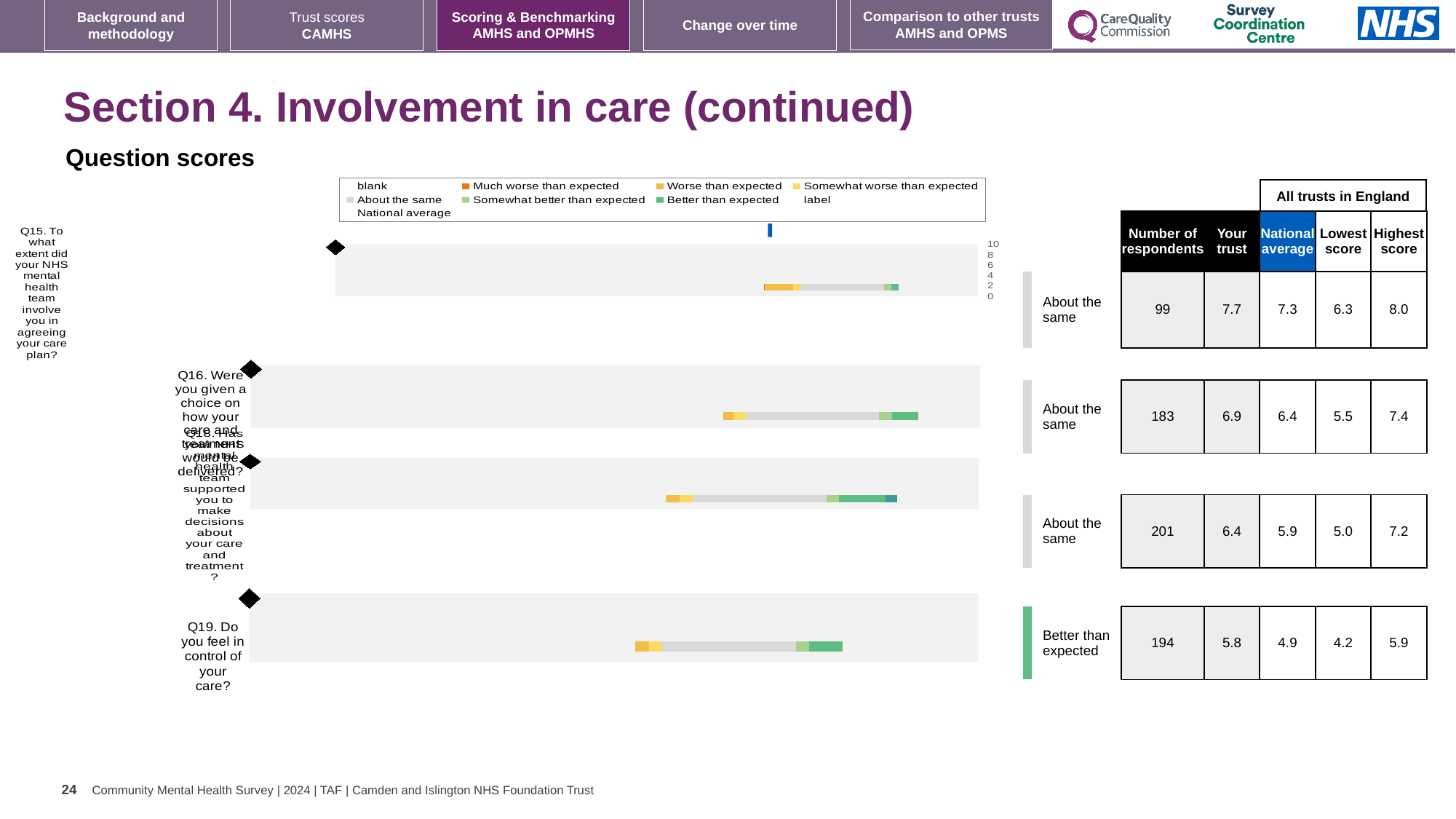
Which question has the highest 'Your trust' score? Q15 What is the highest score among all trusts in England for Q19 (Do you feel in control of your care?)? 5.9 Which question has the lowest 'Your trust' score? Q19 How many questions are plotted in the question scores chart? 4 Which has the higher 'Your trust' score, Q16 or Q18? Q16 What kind of chart is used to show the question scores on this slide? bar chart Is the 'Your trust' score for Q19 greater or less than 6? less Which question is rated 'Better than expected' rather than 'About the same'? Q19 How many respondents answered Q18 (Has your NHS mental health team supported you to make decisions about your care and treatment?)? 201 What is the 'Your trust' score for Q15 (To what extent did your NHS mental health team involve you in agreeing your care plan?)? 7.7 By how much does the trust's score for Q19 exceed the national average for Q19? 0.9 What is the national average score for Q16 (Were you given a choice on how your care and treatment would be delivered?)? 6.4